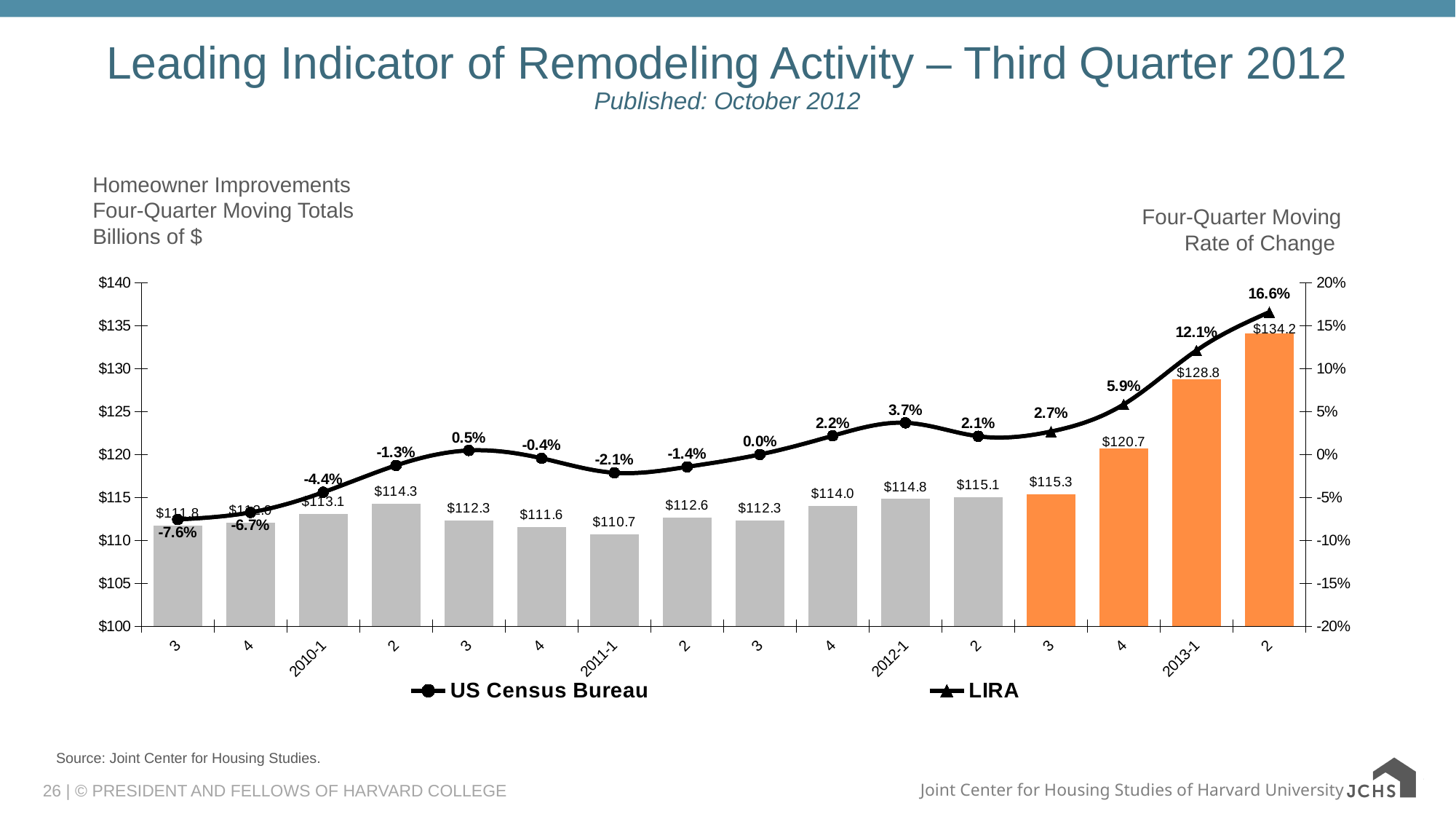
What is the four-quarter moving total for 2011-1? $110.7 What is the highest rate of change shown on the line? 16.6% What is the four-quarter moving rate of change for 2012-1? 3.7% Which is larger, the four-quarter moving total for 2010-1 or for 2011-1? 2010-1 Which period has the lowest four-quarter moving total? 2011-1 How many bars are plotted in the chart? 16 Which period has the highest four-quarter moving total? 2013 quarter 2 (the last bar) How many series does the legend list? 2 What is the difference between the four-quarter moving totals for 2013-1 and 2012-1? $14.0 What are the two series named in the legend? US Census Bureau and LIRA What is the rate of change shown for 2010-1? -4.4% What is the four-quarter moving total for 2013-1? $128.8